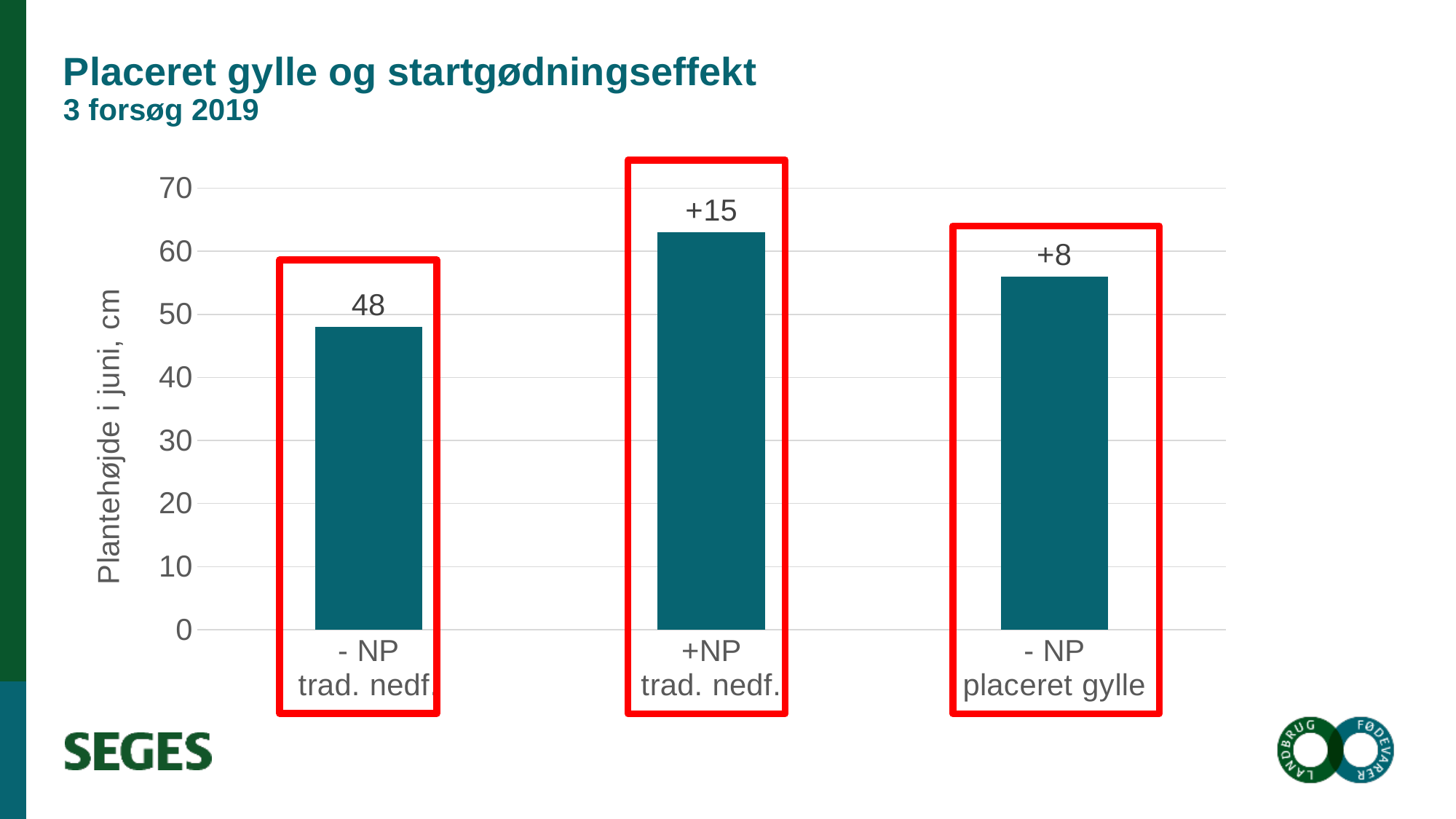
What is the title of the slide? Placeret gylle og startgødningseffekt What kind of chart is shown on the slide? bar chart What is the data label printed above the bar for '+NP trad. nedf.'? +15 How many bars are shown in the chart? 3 What is the data label printed above the bar for '- NP placeret gylle'? +8 What is the data label printed above the bar for '- NP trad. nedf.'? 48 Which bar is taller: '- NP placeret gylle' or '- NP trad. nedf.'? - NP placeret gylle Is the bar for '+NP trad. nedf.' greater or less than 60? greater What is the label of the vertical axis? Plantehøjde i juni, cm Which category has the shortest bar? - NP trad. nedf. Is the bar for '- NP placeret gylle' greater or less than 60? less Which category has the tallest bar? +NP trad. nedf.